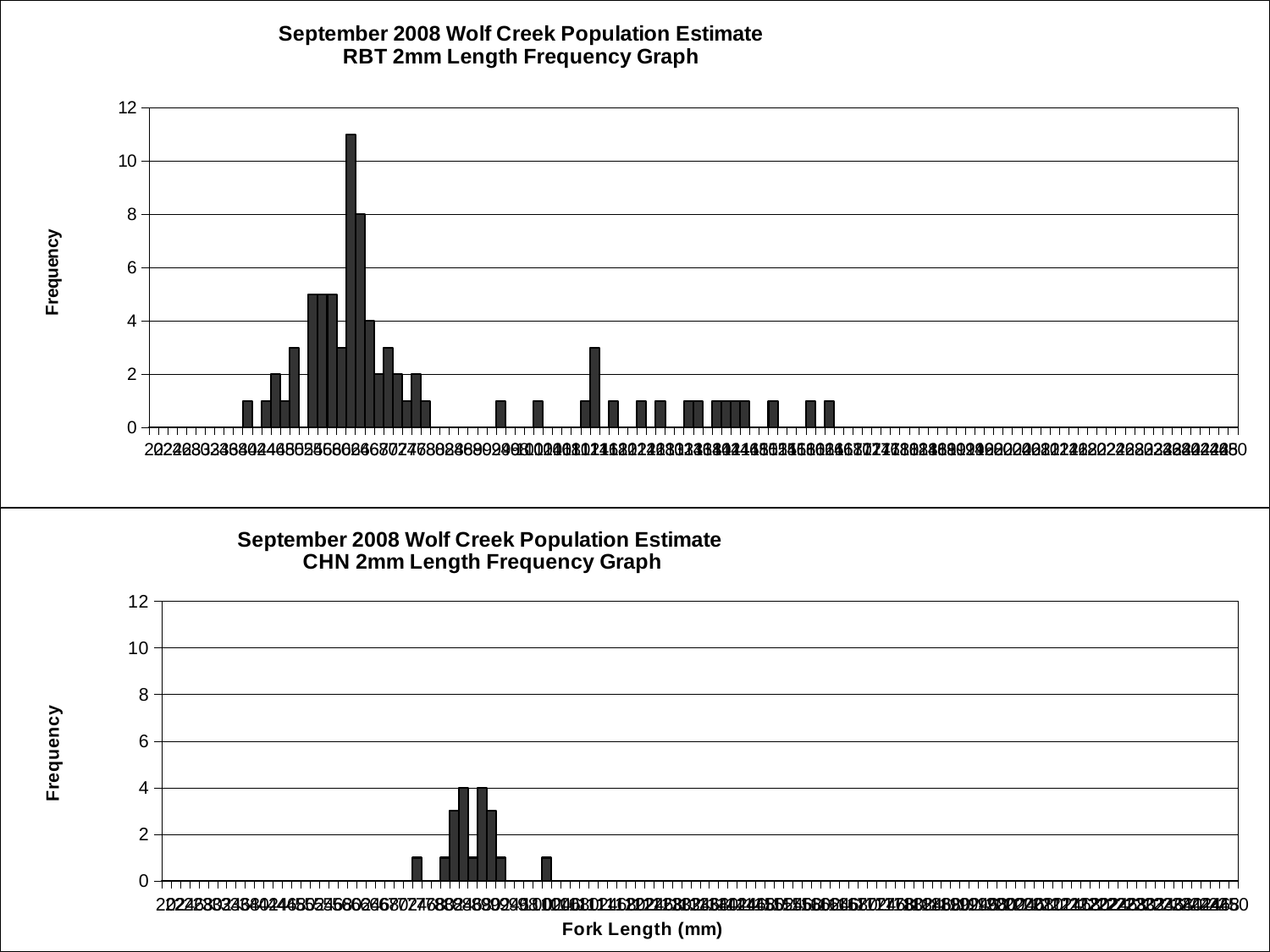
In the RBT 2mm Length Frequency Graph (top chart), is the tallest bar greater or less than 10? greater In the RBT 2mm Length Frequency Graph (top chart), what is the maximum value shown on the Frequency axis? 12 What kind of chart is the top chart, titled 'September 2008 Wolf Creek Population Estimate RBT 2mm Length Frequency Graph'? bar chart In the CHN 2mm Length Frequency Graph (bottom chart), what is the highest frequency reached by any bar? 4 What kind of chart is the bottom chart, titled 'September 2008 Wolf Creek Population Estimate CHN 2mm Length Frequency Graph'? bar chart In the CHN 2mm Length Frequency Graph (bottom chart), how many bars reach a frequency of 4? 2 In the RBT 2mm Length Frequency Graph (top chart), is the second-tallest bar greater or less than 6? greater What is the label on the horizontal axis of the CHN 2mm Length Frequency Graph (bottom chart)? Fork Length (mm) In the CHN 2mm Length Frequency Graph (bottom chart), is the tallest bar greater or less than 6? less Which chart has the higher maximum frequency, the RBT chart (top) or the CHN chart (bottom)? RBT chart (top)